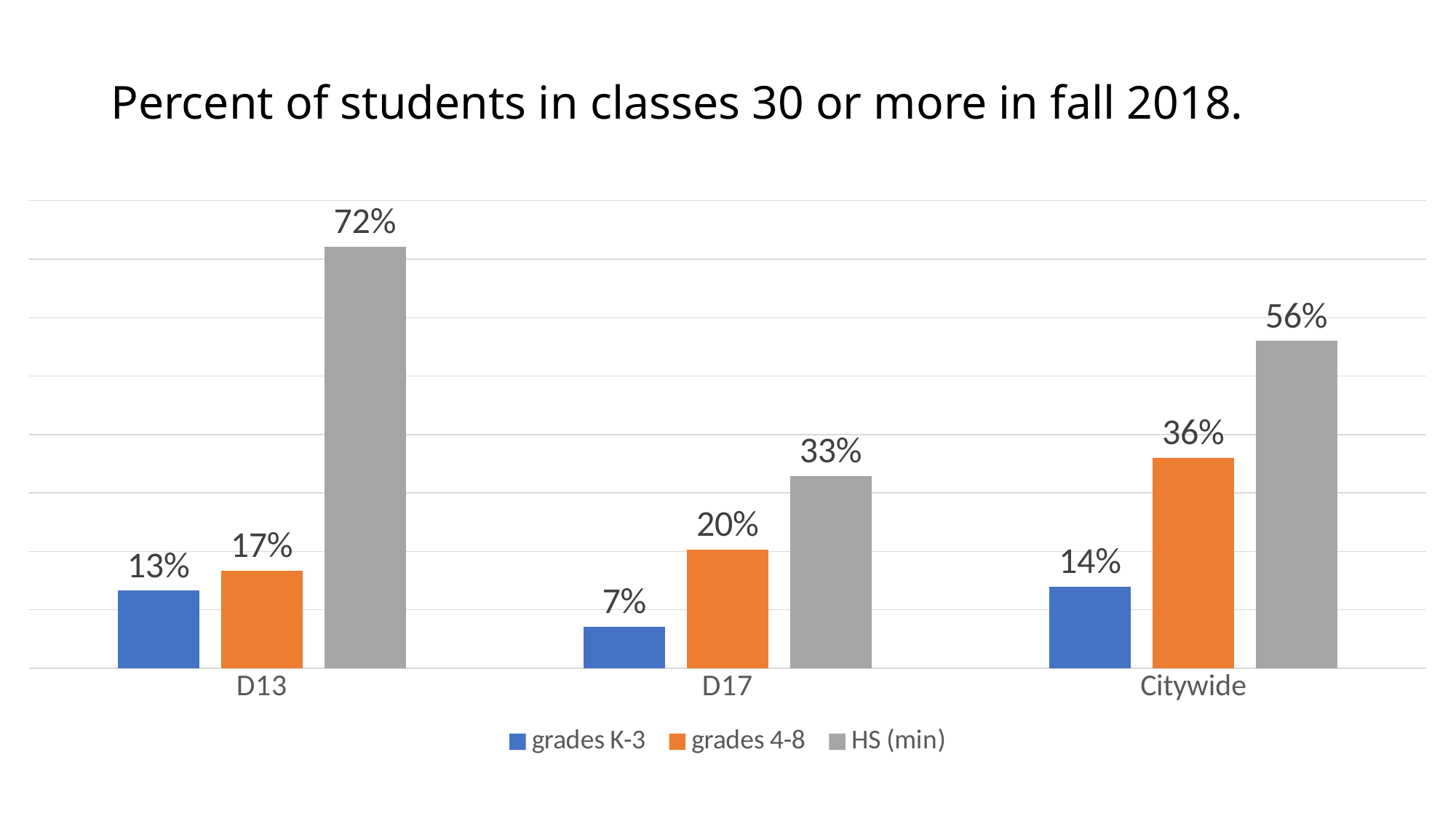
How many series does the legend list? 3 Which colour represents the HS (min) series? gray What is the value for grades 4-8 in Citywide? 36% What is the difference between the HS (min) values for D13 and Citywide? 16% What is the value for HS (min) in D17? 33% Which category has the highest HS (min) value? D13 Which is larger, grades 4-8 in D17 or grades 4-8 in Citywide? grades 4-8 in Citywide Which category has the lowest grades K-3 value? D17 How many categories are shown on the x axis? 3 What is the title of the chart? Percent of students in classes 30 or more in fall 2018. What kind of chart is shown on the slide? bar chart What is the value for grades K-3 in D13? 13%